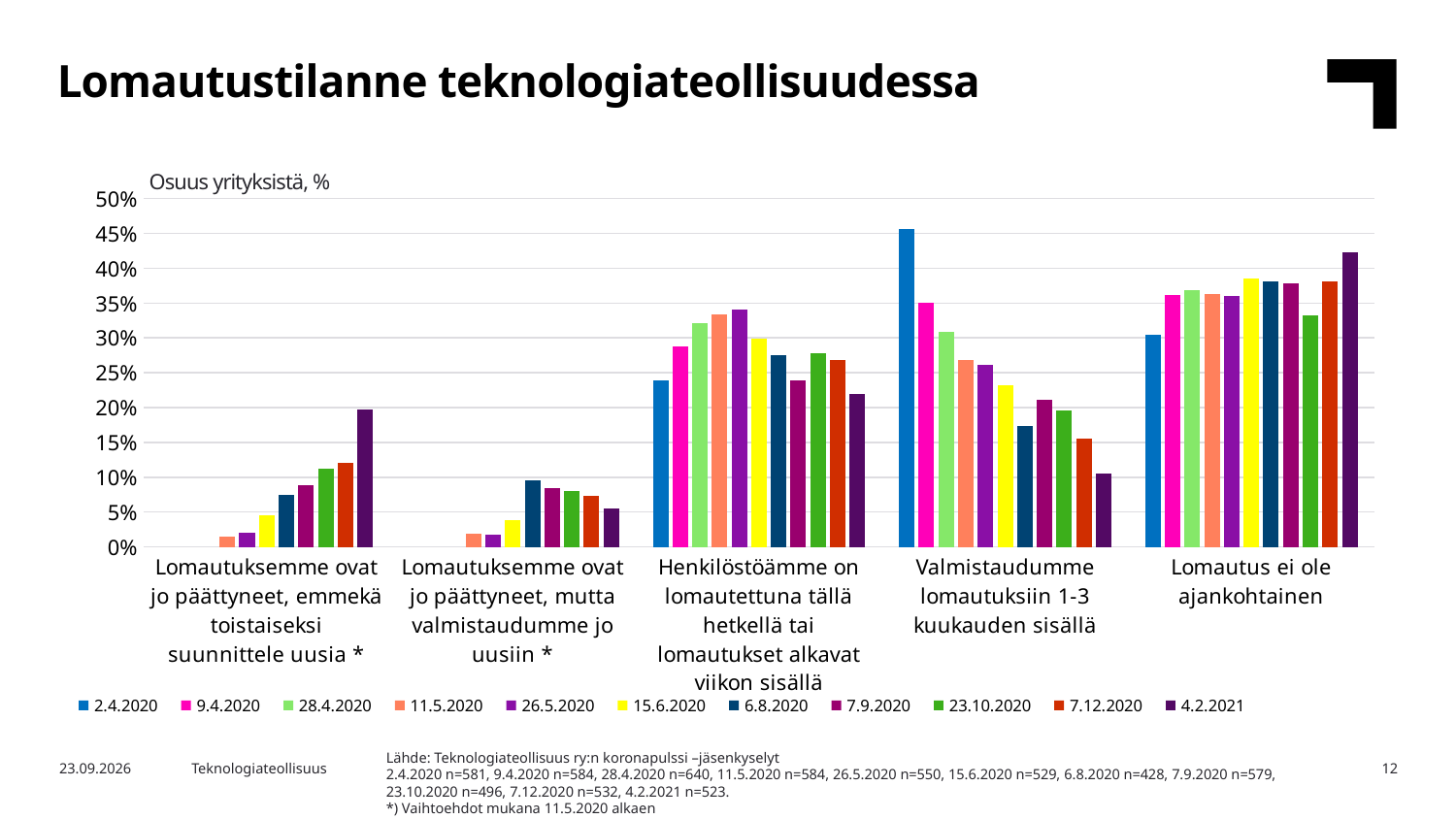
What kind of chart is shown on the slide? Bar chart What is the label shown above the vertical axis of the chart? Osuus yrityksistä, % How many categories are shown on the x axis of the chart? 5 In the category 'Valmistaudumme lomautuksiin 1-3 kuukauden sisällä', which series has the lowest bar? 4.2.2021 In the category 'Lomautus ei ole ajankohtainen', which series has the highest bar? 4.2.2021 Is the value for 6.8.2020 in 'Lomautuksemme ovat jo päättyneet, mutta valmistaudumme jo uusiin' greater or less than 15%? less How many series does the chart legend list? 11 Is the value for 2.4.2020 in 'Valmistaudumme lomautuksiin 1-3 kuukauden sisällä' greater or less than 40%? greater Is the value for 4.2.2021 in 'Lomautuksemme ovat jo päättyneet, emmekä toistaiseksi suunnittele uusia' greater or less than 15%? greater Which category has the highest bar for the 2.4.2020 series? Valmistaudumme lomautuksiin 1-3 kuukauden sisällä For the 2.4.2020 series, which is larger: the bar for 'Valmistaudumme lomautuksiin 1-3 kuukauden sisällä' or the bar for 'Lomautus ei ole ajankohtainen'? Valmistaudumme lomautuksiin 1-3 kuukauden sisällä